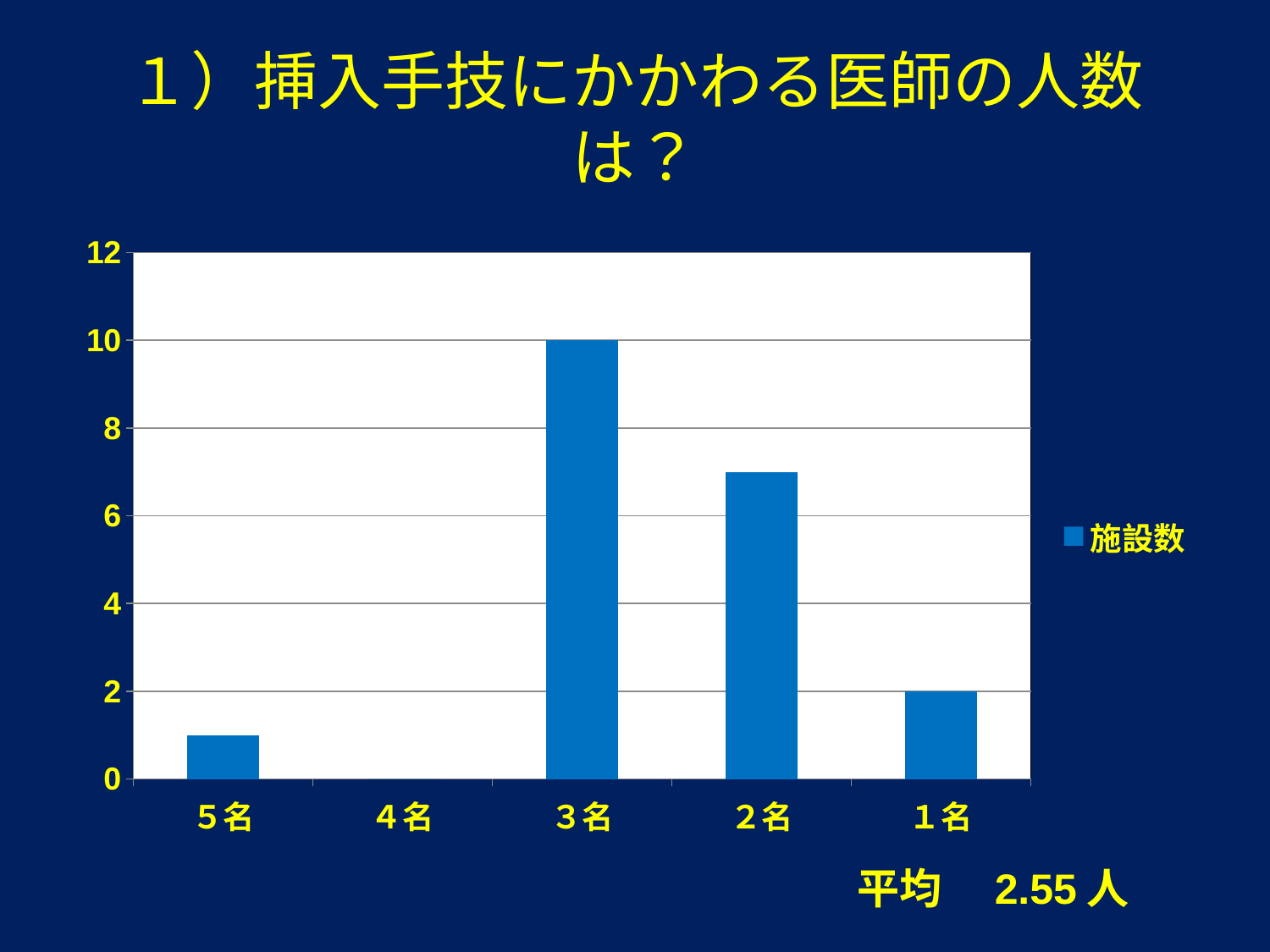
What is the difference between the values for 3名 and 1名? 8 What is the name of the series shown in the chart legend? 施設数 What is the value for 1名? 2 Which is larger, the value for 2名 or the value for 1名? 2名 What type of chart is shown on the slide? bar chart Which category has no bar at all in the chart? 4名 What is the value for 3名? 10 Is the value for 2名 greater or less than 6? greater How many categories are shown on the x axis of the chart? 5 Which category has the highest value in the chart? 3名 Is the value for 5名 greater or less than 2? less How many series does the chart legend list? 1